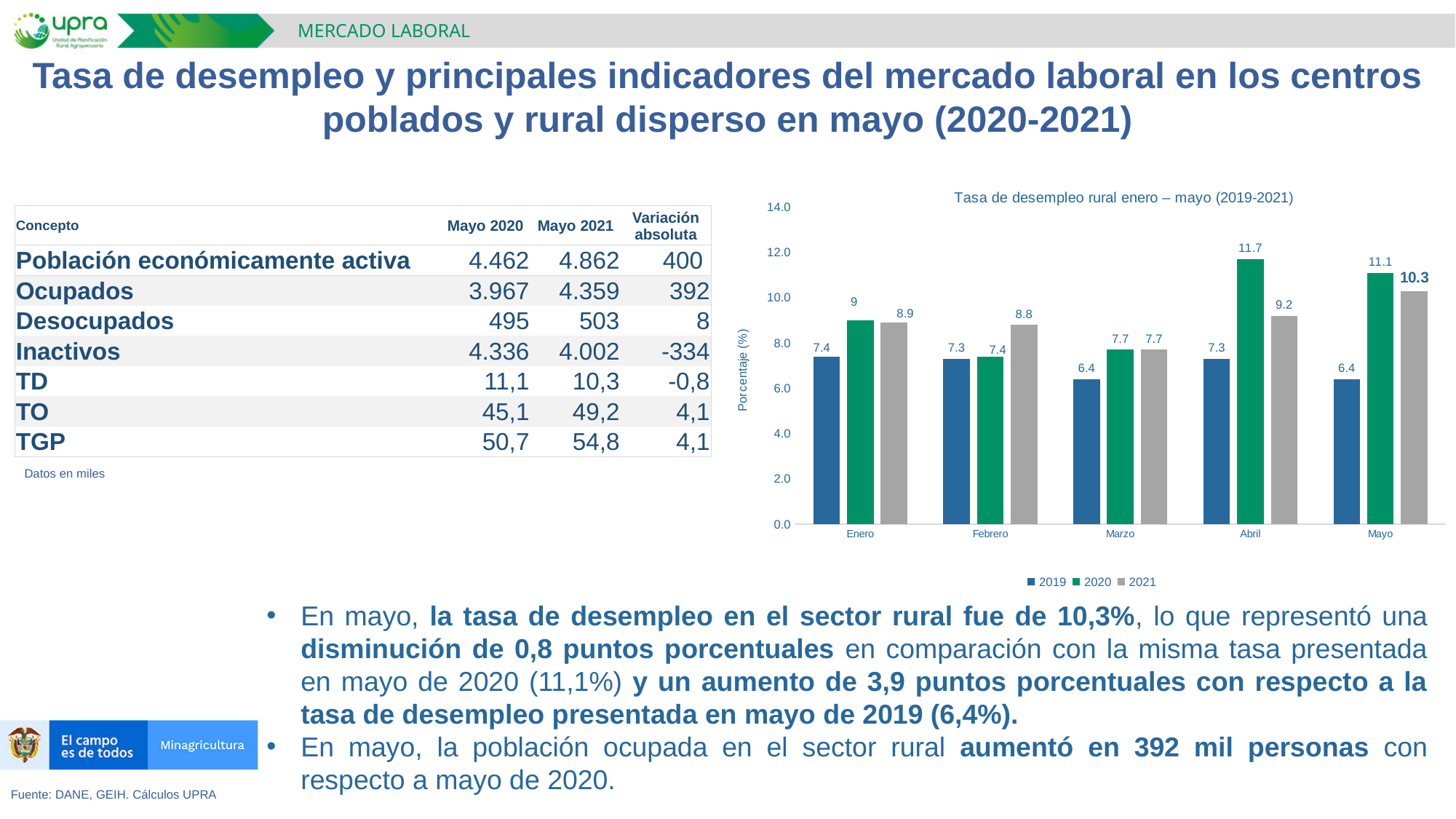
Which month has the lowest value for the 2021 series? Marzo What is the value for 2020 in Abril? 11.7 What kind of chart is shown? Bar chart What is the value for 2021 in Febrero? 8.8 Which month has the highest value for the 2020 series? Abril How many months are shown on the x axis? 5 What is the title of the chart? Tasa de desempleo rural enero – mayo (2019-2021) In Enero, which is larger: the 2020 value or the 2021 value? 2020 What is the value for 2019 in Enero? 7.4 What is the value for 2021 in Mayo? 10.3 How many series does the legend list? 3 What is the difference between the 2020 and 2019 values in Mayo? 4.7